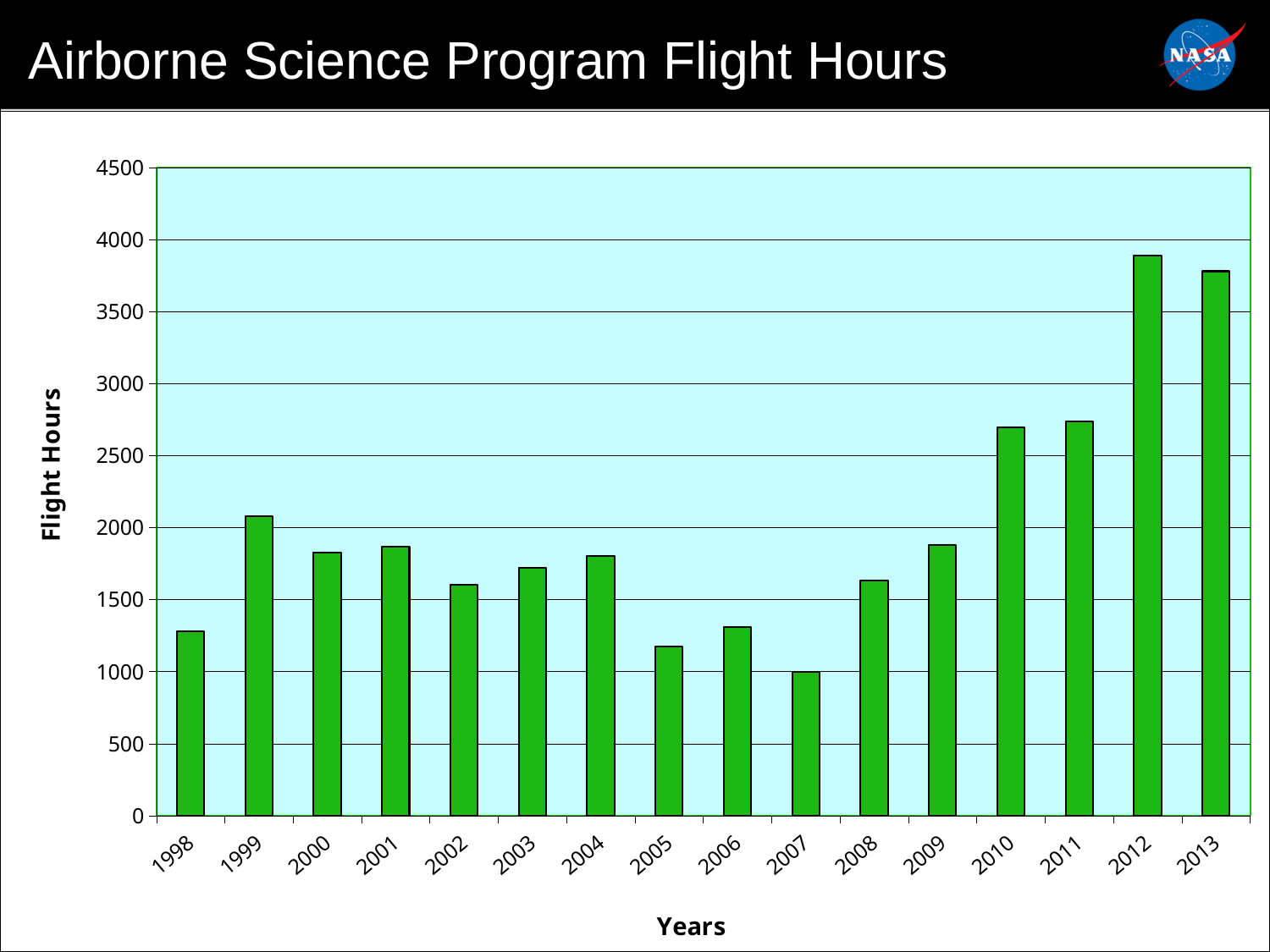
Which year has the lowest flight hours? 2007 Is the value for 2012 greater or less than 3500? greater What kind of chart is shown on the slide? bar chart How many years are plotted on the x axis? 16 Which year has the highest flight hours? 2012 What is the label on the vertical axis? Flight Hours Is the value for 1998 greater or less than 1500? less Is the value for 2005 greater or less than 1500? less Do the flight hours rise or fall from 2007 to 2012? rise Which year has more flight hours, 2008 or 2009? 2009 Which year has more flight hours, 1999 or 2000? 1999